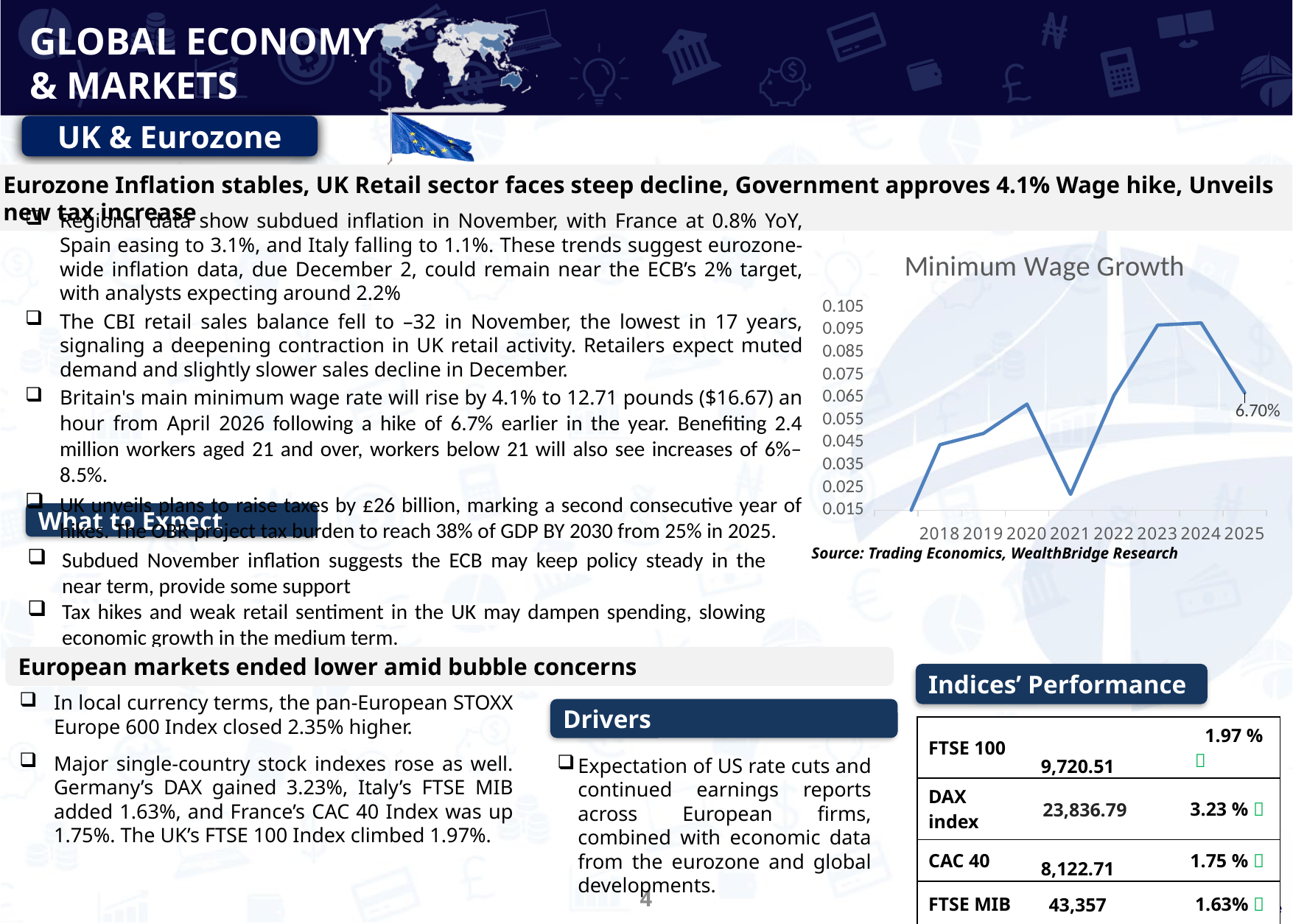
On the Minimum Wage Growth chart, which is larger, the value for 2023 or the value for 2021? 2023 On the Minimum Wage Growth chart, do values rise or fall from 2021 to 2023? rise Is the value for 2022 on the Minimum Wage Growth chart greater or less than 0.055? greater Is the value for 2021 on the Minimum Wage Growth chart greater or less than 0.035? less On the Minimum Wage Growth chart, which is larger, the value for 2025 or the value for 2018? 2025 What is the title of the chart on the slide? Minimum Wage Growth What value is labelled for 2025 on the Minimum Wage Growth chart? 6.70% Which year has the lowest value on the Minimum Wage Growth chart? 2021 What source is cited below the Minimum Wage Growth chart? Trading Economics, WealthBridge Research How many years are shown on the x axis of the Minimum Wage Growth chart? 8 What type of chart is the Minimum Wage Growth chart? line chart Is the value for 2023 on the Minimum Wage Growth chart greater or less than 0.085? greater